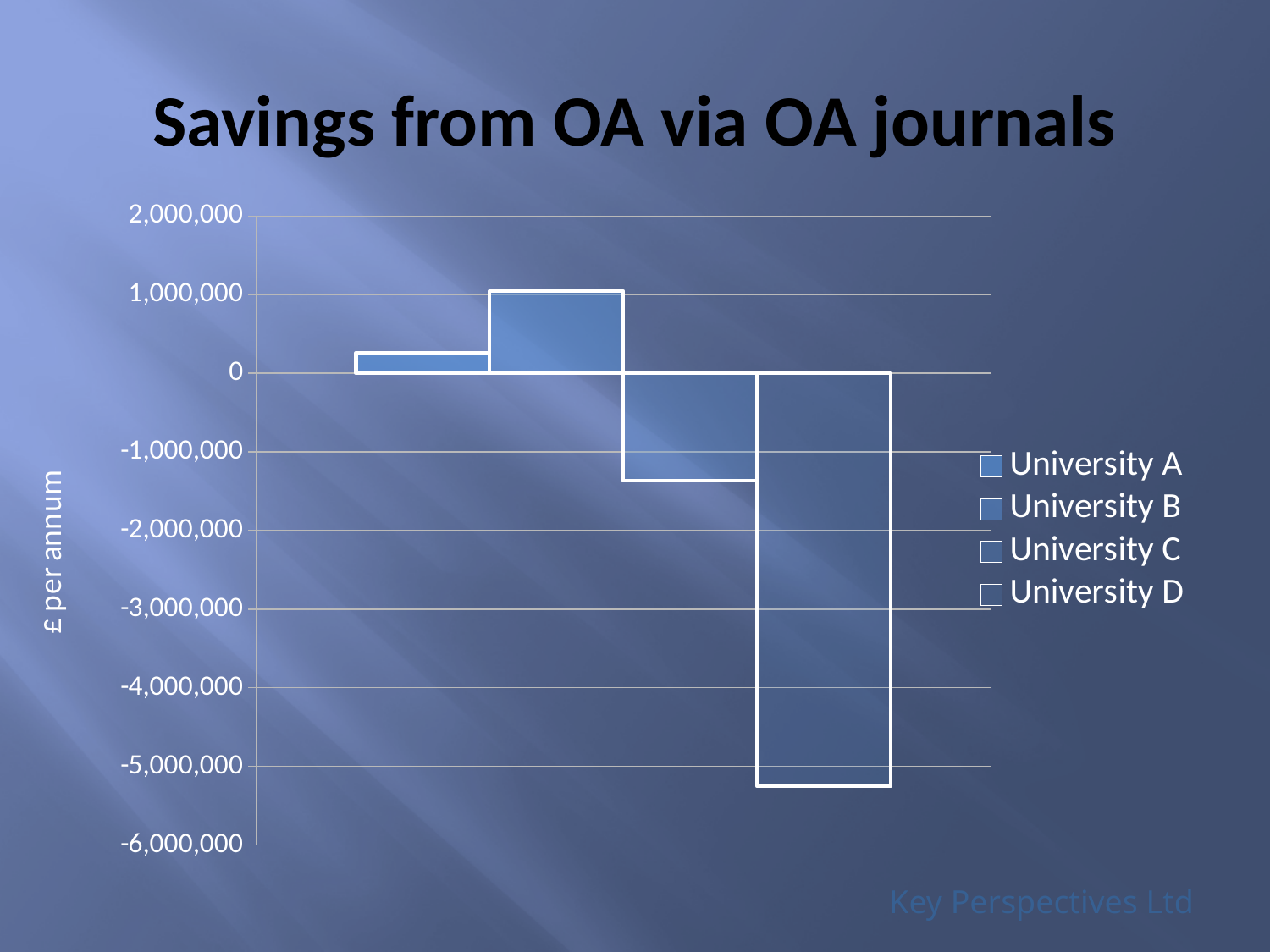
What is the label on the vertical axis? £ per annum Is the value for University C greater or less than -1,000,000? less Which is larger, the value for University C or University D? University C Is the value for University A greater or less than 0? greater What kind of chart is shown on the slide? bar chart Which is larger, the value for University A or University B? University B How many series does the legend list? 4 Is the value for University D greater or less than -5,000,000? less What is the title of the chart? Savings from OA via OA journals How many bars are plotted in the chart? 4 Which university has the highest value? University B Which university has the lowest value? University D